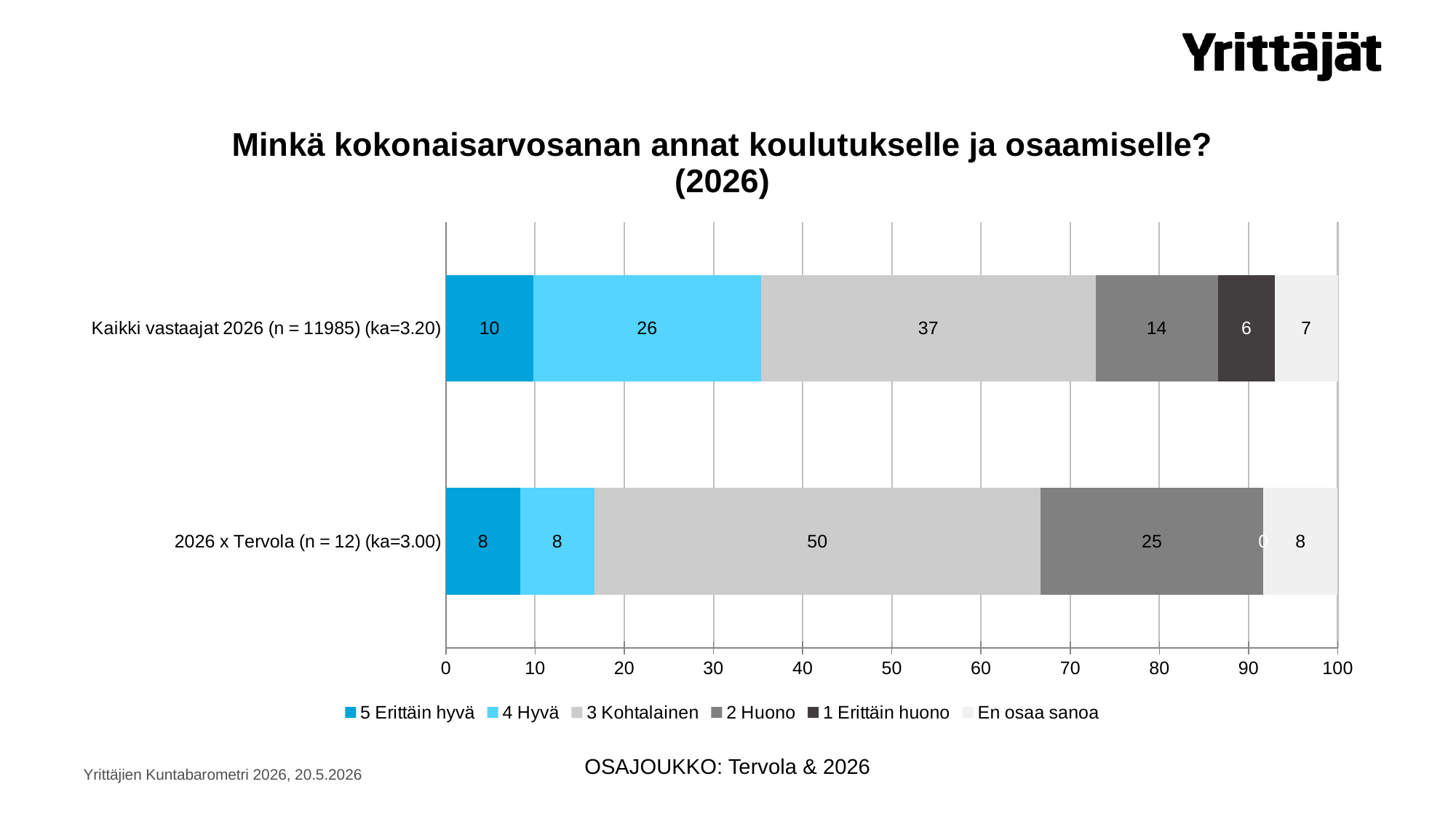
What is the difference between the "3 Kohtalainen" values for "2026 x Tervola (n = 12) (ka=3.00)" and "Kaikki vastaajat 2026 (n = 11985) (ka=3.20)"? 13 What is the total of the stacked bar for "Kaikki vastaajat 2026 (n = 11985) (ka=3.20)"? 100 Which series has the highest value for "2026 x Tervola (n = 12) (ka=3.00)"? 3 Kohtalainen Which is larger: the "4 Hyvä" value for "Kaikki vastaajat 2026 (n = 11985) (ka=3.20)" or for "2026 x Tervola (n = 12) (ka=3.00)"? Kaikki vastaajat 2026 (n = 11985) (ka=3.20) What kind of chart is shown on the slide? Stacked bar chart What is the value of "5 Erittäin hyvä" for "Kaikki vastaajat 2026 (n = 11985) (ka=3.20)"? 10 Which series has the lowest value for "Kaikki vastaajat 2026 (n = 11985) (ka=3.20)"? 1 Erittäin huono How many categories (bars) are shown on the chart? 2 What is the value of "2 Huono" for "2026 x Tervola (n = 12) (ka=3.00)"? 25 What is the value of "3 Kohtalainen" for "Kaikki vastaajat 2026 (n = 11985) (ka=3.20)"? 37 What is the value of "1 Erittäin huono" for "2026 x Tervola (n = 12) (ka=3.00)"? 0 How many series does the legend list? 6